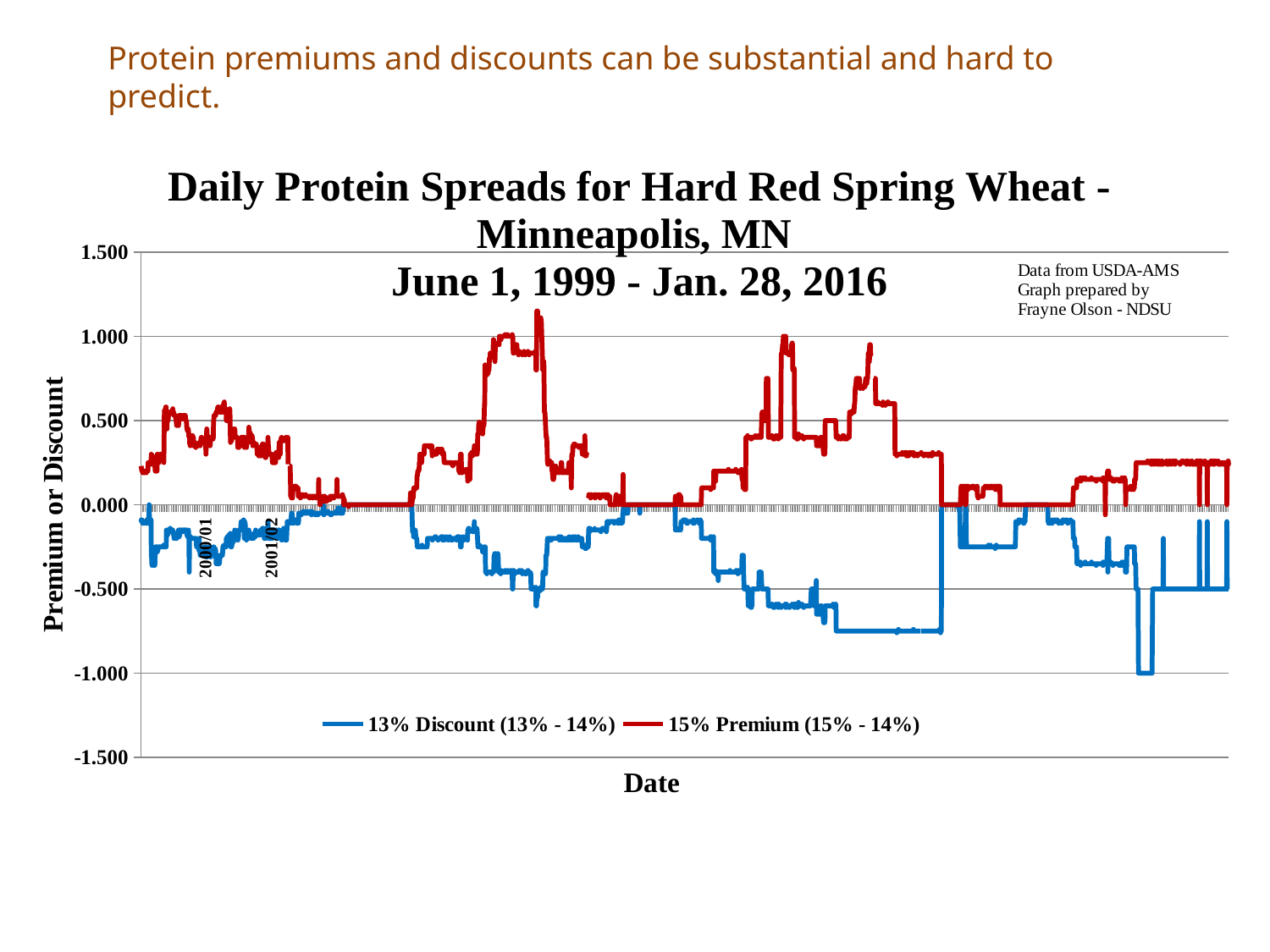
What are the two series named in the legend? 13% Discount (13% - 14%) and 15% Premium (15% - 14%) Which series reaches the higher values on the chart, 13% Discount (13% - 14%) or 15% Premium (15% - 14%)? 15% Premium (15% - 14%) Is the highest value reached by the 15% Premium (15% - 14%) series greater or less than 1.000? greater Which series reaches the lowest value on the chart? 13% Discount (13% - 14%) Which series reaches the highest value on the chart? 15% Premium (15% - 14%) Is the lowest value reached by the 13% Discount (13% - 14%) series greater or less than -0.500? less How many series does the legend list? 2 What kind of chart is shown on the slide? Line chart Is the highest value reached by the 13% Discount (13% - 14%) series greater or less than 0.500? less What is the label on the vertical axis of the chart? Premium or Discount